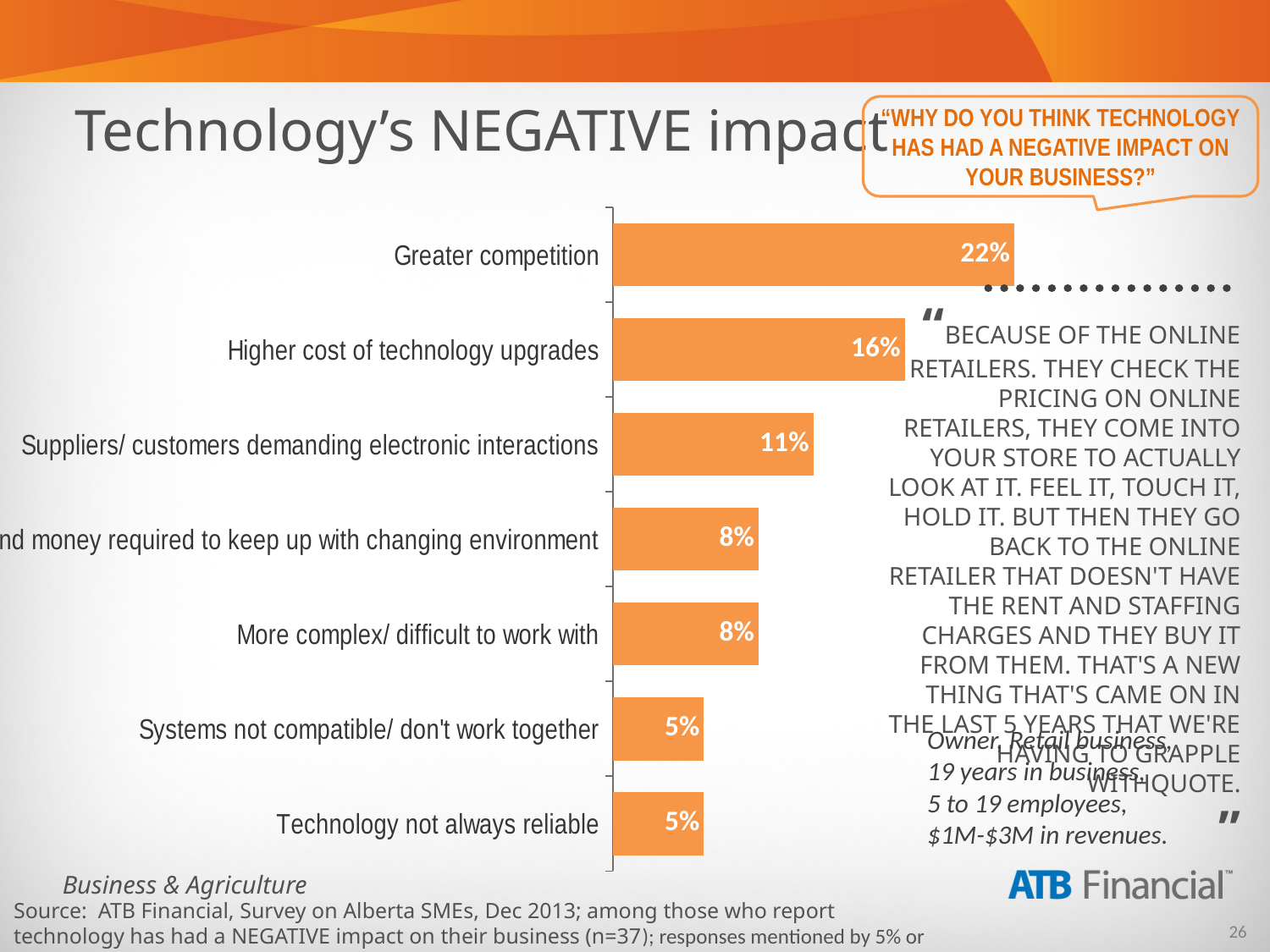
What percentage of respondents cited "Greater competition" as a negative impact of technology? 22% What percentage is shown for "Suppliers/ customers demanding electronic interactions"? 11% How many categories are shown in the bar chart? 7 What is the title of the slide containing the chart? Technology's NEGATIVE impact What percentage is shown for "Technology not always reliable"? 5% What is the difference in percentage points between "Greater competition" and "Higher cost of technology upgrades"? 6 percentage points Which has a larger value: "Higher cost of technology upgrades" or "Suppliers/ customers demanding electronic interactions"? Higher cost of technology upgrades Which category has the highest value in the chart? Greater competition What type of chart is used on this slide? Bar chart What value is shown for "More complex/ difficult to work with"? 8% What is the value shown for "Higher cost of technology upgrades"? 16% Do the values increase or decrease going from the top bar to the bottom bar? Decrease